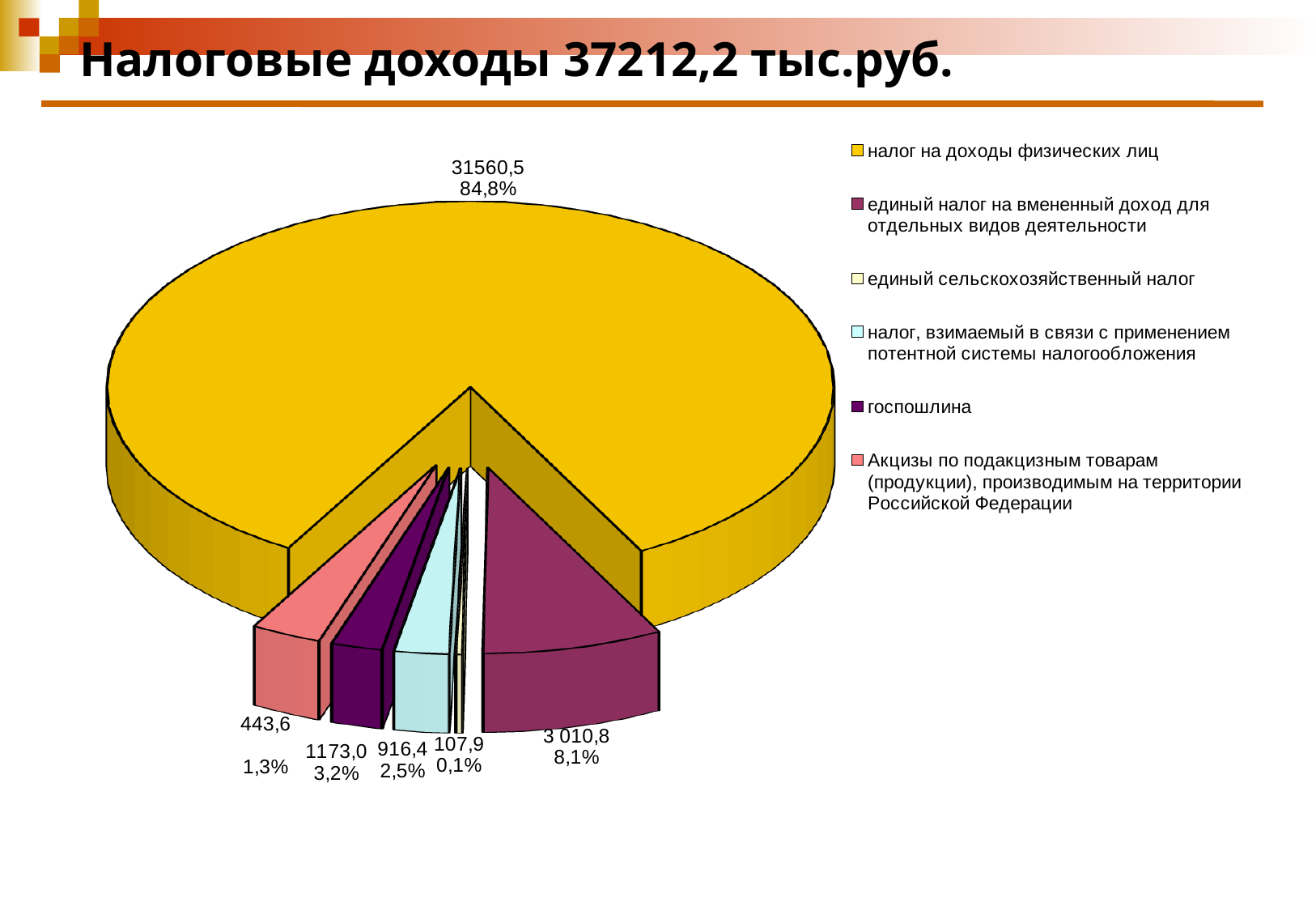
What is the difference between the value for госпошлина and the value for налог, взимаемый в связи с применением потентной системы налогообложения? 256,6 What is the value shown for единый налог на вмененный доход для отдельных видов деятельности? 3 010,8 What kind of chart is shown on the slide? pie chart What share of the pie does налог на доходы физических лиц take? 84,8% What is the value shown for Акцизы по подакцизным товарам (продукции), производимым на территории Российской Федерации? 443,6 What is the value shown for налог, взимаемый в связи с применением потентной системы налогообложения? 916,4 What is the value shown for налог на доходы физических лиц? 31560,5 What share of the pie does госпошлина take? 3,2% Which category has the largest slice of the pie? налог на доходы физических лиц Which category has the smallest slice of the pie? единый сельскохозяйственный налог How many entries does the legend of the pie chart list? 6 Which is larger, the value for госпошлина or the value for Акцизы по подакцизным товарам? госпошлина